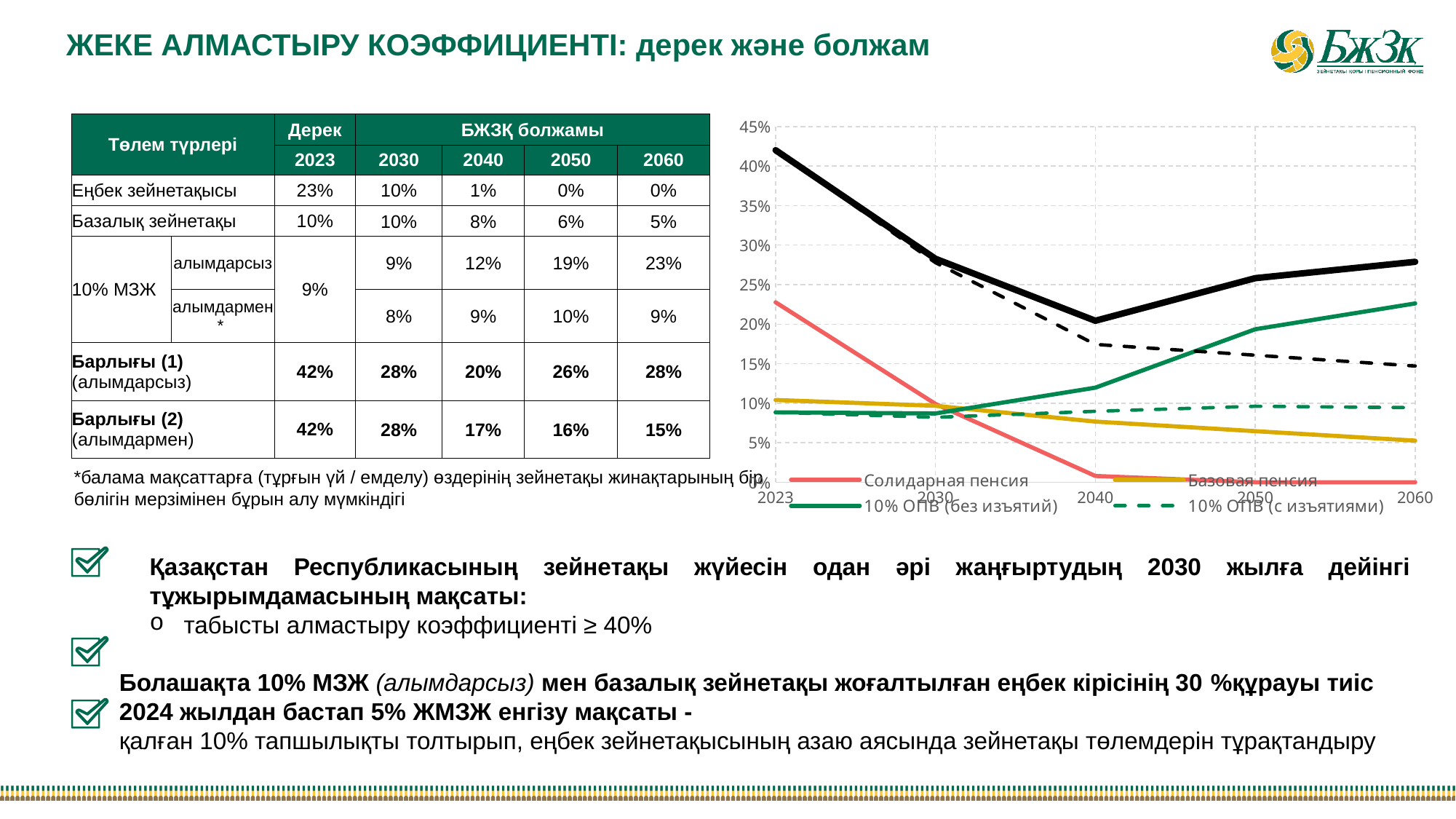
How many series does the chart legend list? 4 Does the 10% ОПВ (без изъятий) line rise or fall from 2023 to 2060? rise Is the value for Базовая пенсия in 2060 greater or less than 10%? less What kind of chart is shown on the right side of the slide? line chart Is the value for 10% ОПВ (без изъятий) in 2060 greater or less than 15%? greater How many years are marked along the x axis of the chart? 5 In 2060, which is larger: 10% ОПВ (без изъятий) or Базовая пенсия? 10% ОПВ (без изъятий) In which year does the 10% ОПВ (без изъятий) line reach its highest value? 2060 Which legend series is drawn as a dashed green line? 10% ОПВ (с изъятиями) Is the value for Солидарная пенсия in 2023 greater or less than 15%? greater Does the Солидарная пенсия line rise or fall from 2023 to 2060? fall